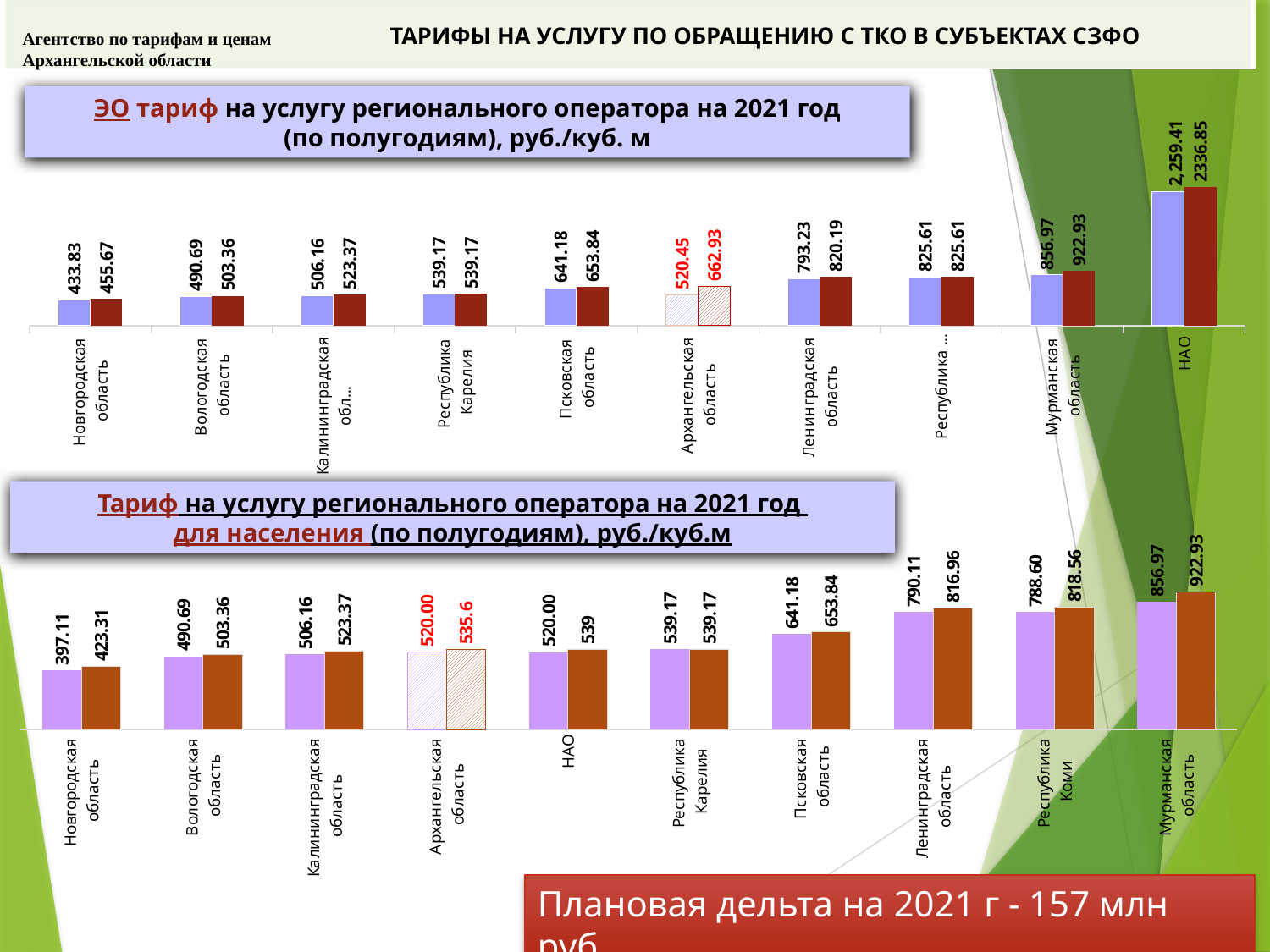
In the top chart (ЭО тариф), how many regions are shown on the x axis? 10 In the top chart (ЭО тариф), what is the value of the first (left) bar for Новгородская область? 433.83 In the top chart (ЭО тариф), what is the difference between the second and first bar values for Архангельская область? 142.48 In the bottom chart (Тариф для населения), what is the difference between the second and first bar values for Мурманская область? 65.96 In the bottom chart (Тариф для населения), what is the value of the first (left) bar for Ленинградская область? 790.11 In the top chart (ЭО тариф на услугу регионального оператора на 2021 год), what is the value of the second (right) bar for Архангельская область? 662.93 In the bottom chart (Тариф для населения), which region has the highest values? Мурманская область In the top chart (ЭО тариф), which region has the lowest values? Новгородская область What type of chart is used in both charts on the slide? Bar chart In the bottom chart (Тариф для населения), which is larger: the second bar for Псковская область or the second bar for Республика Карелия? Псковская область In the bottom chart (Тариф для населения), what is the value of the second (right) bar for Архангельская область? 535.6 In the top chart (ЭО тариф), which region has the highest values? НАО